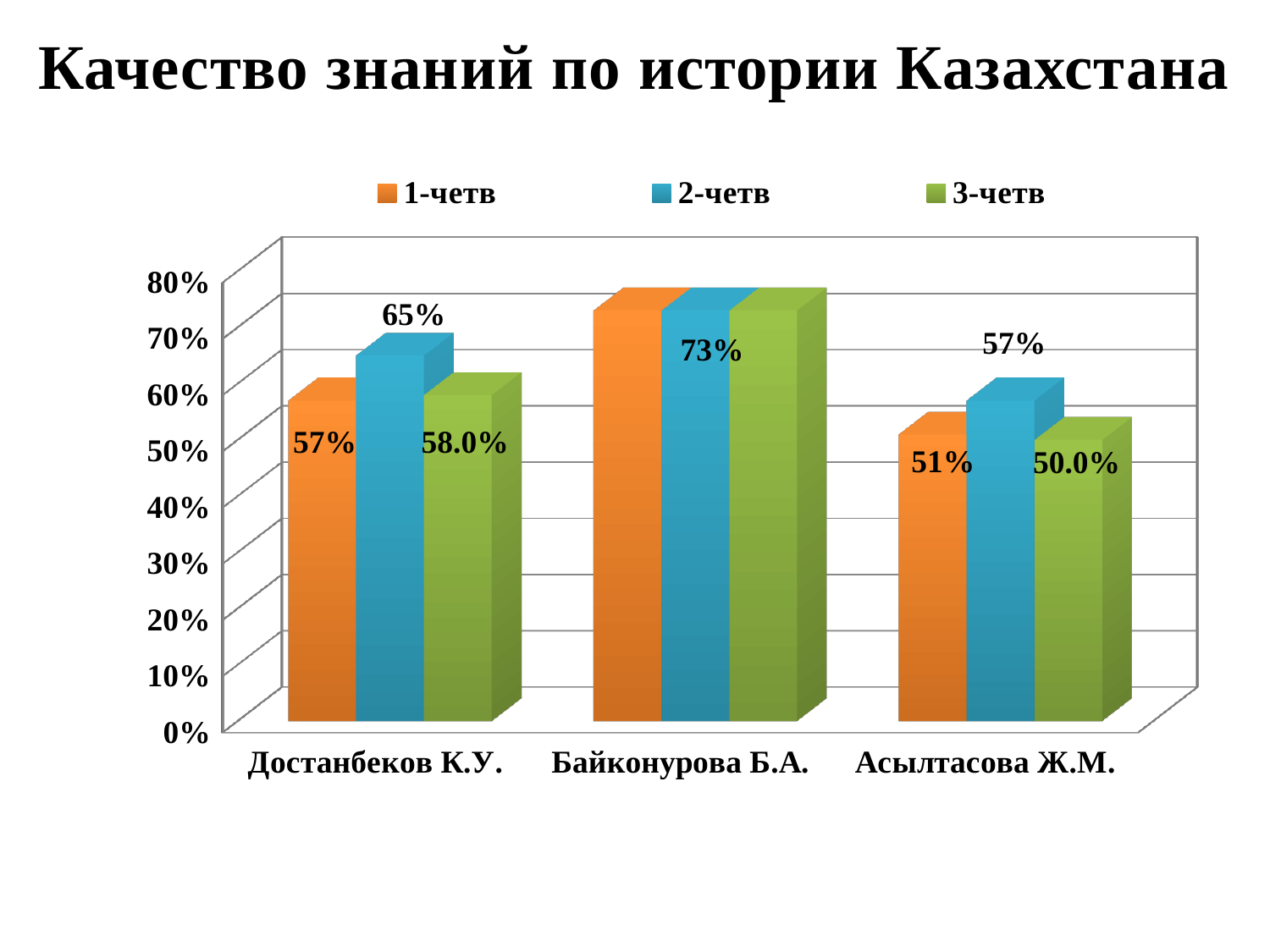
What is the value for Достанбеков К.У. in the 3-четв series? 58.0% What kind of chart is shown on the slide? bar chart What is the value for Достанбеков К.У. in the 1-четв series? 57% Is the 1-четв value for Байконурова Б.А. greater or less than 70%? greater Which is larger: the 1-четв value for Достанбеков К.У. or the 1-четв value for Асылтасова Ж.М.? Достанбеков К.У. By how much does the 2-четв value for Достанбеков К.У. exceed the 1-четв value? 8% What is the value for Достанбеков К.У. in the 2-четв series? 65% Which teacher has the highest values across all quarters? Байконурова Б.А. What is the value for Асылтасова Ж.М. in the 3-четв series? 50.0% How many series does the legend list? 3 What is the value for Асылтасова Ж.М. in the 2-четв series? 57% What is the value for Асылтасова Ж.М. in the 1-четв series? 51%